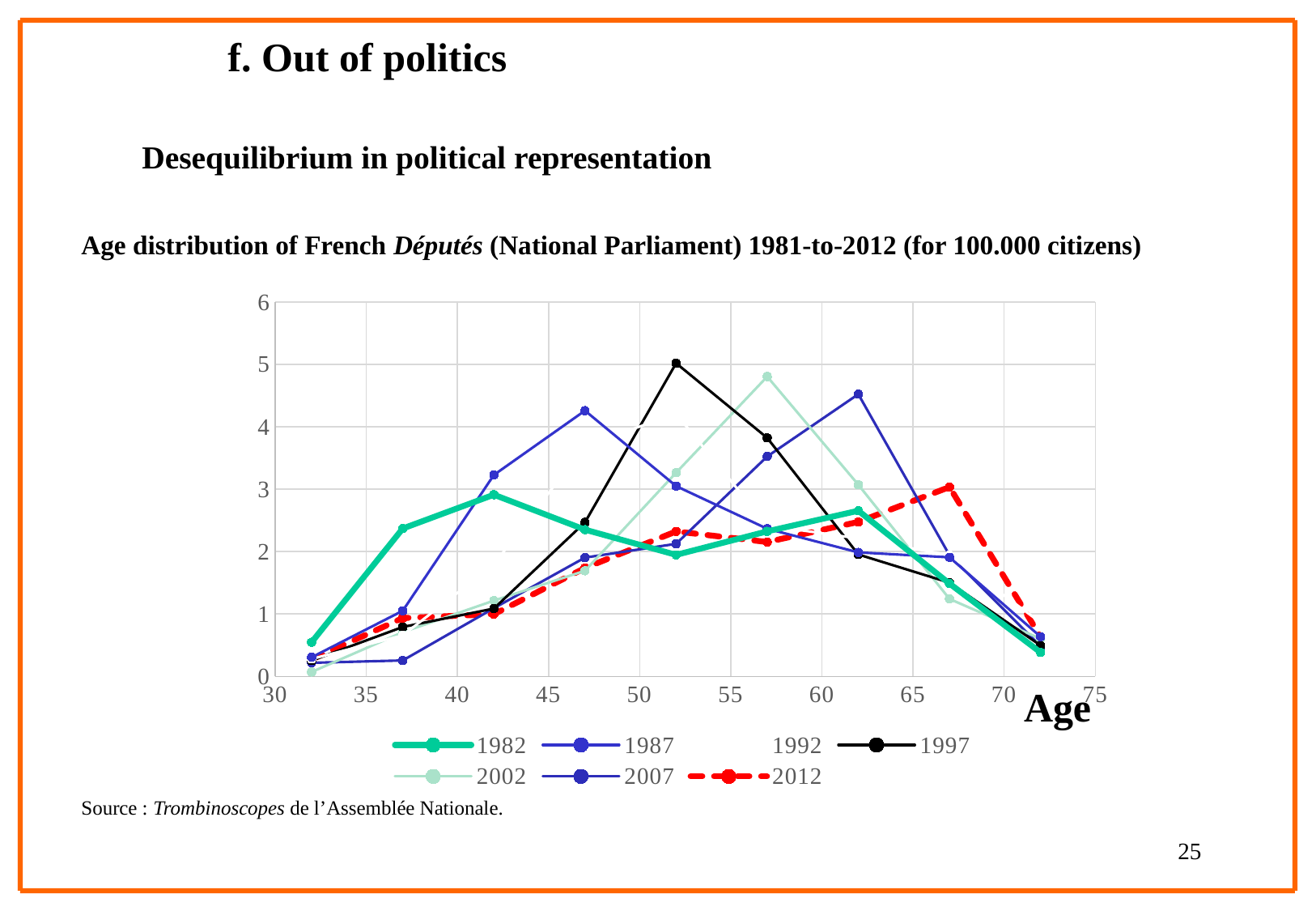
Does the 1982 series rise or fall between age 32 and age 42? rise Is the value for the 2002 series at age 57 greater or less than 4? greater Is the value for the 1982 series at age 32 greater or less than 1? less What kind of chart is shown on the slide? line chart How many series does the legend list? 7 Which series is drawn as a red dashed line? 2012 Is the value for the 1997 series at age 52 greater or less than 4? greater At age 52, which series has the larger value, 1997 or 1982? 1997 At age 37, which series has the larger value, 1982 or 1987? 1982 Does the 2012 series rise or fall between age 67 and age 72? fall At age 67, which series has the larger value, 2012 or 2002? 2012